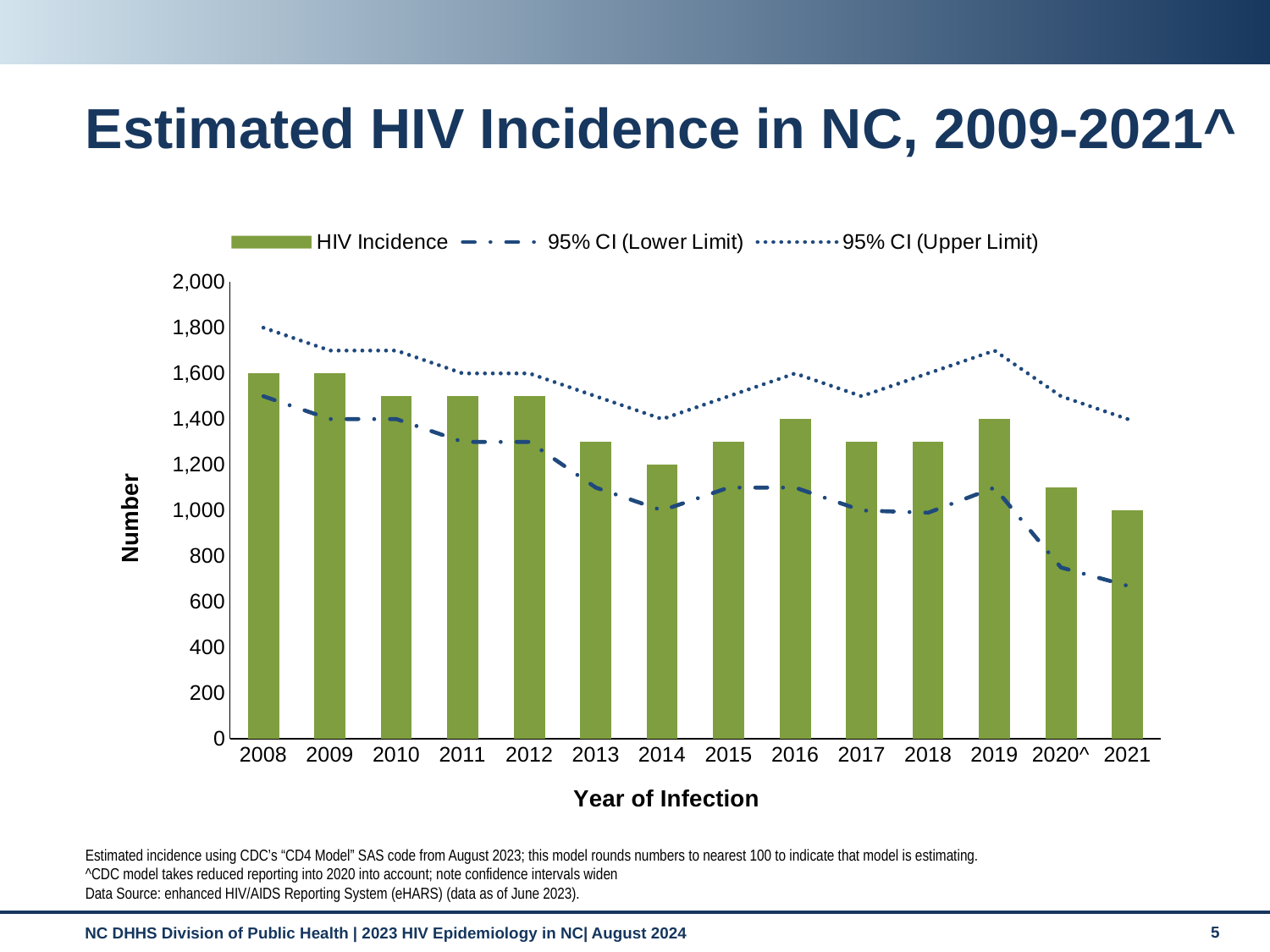
How many years are shown on the x axis? 14 How many series does the legend list? 3 What is the HIV Incidence value for 2014? 1,200 Which year has the lowest HIV Incidence? 2021 Is the HIV Incidence value for 2020^ greater or less than 1,200? less What is the HIV Incidence value for 2021? 1,000 Is the HIV Incidence value for 2012 greater or less than 1,400? greater What is the HIV Incidence value for 2008? 1,600 Which year has the higher HIV Incidence, 2016 or 2014? 2016 Overall, does HIV Incidence rise or fall from 2008 to 2021? fall What is the difference between the HIV Incidence in 2008 and in 2021? 600 What is the HIV Incidence value for 2019? 1,400